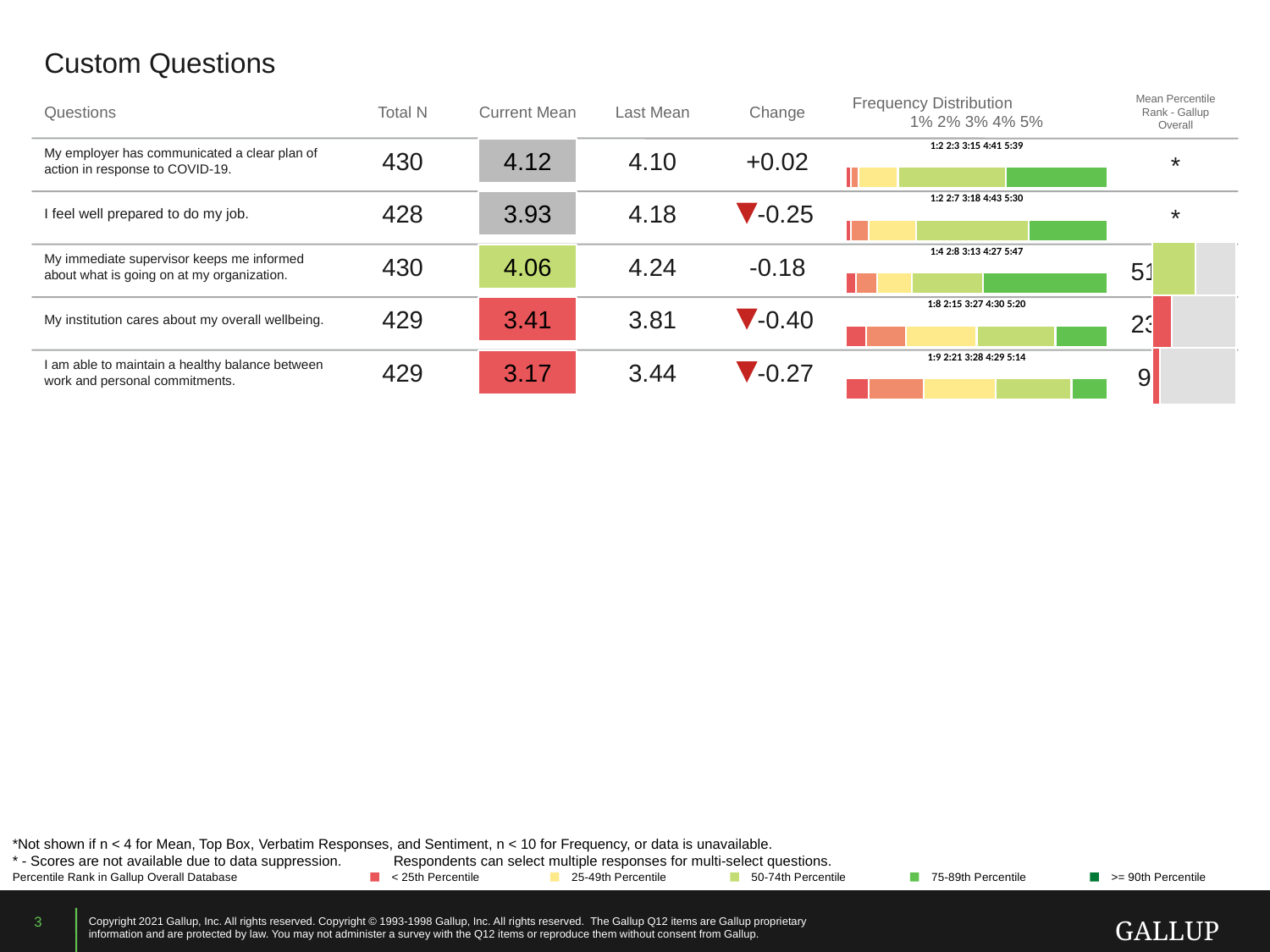
In the Frequency Distribution bar for "My employer has communicated a clear plan of action in response to COVID-19", what percentage chose 5? 39 In the Frequency Distribution bar for "I feel well prepared to do my job", what percentage of respondents chose 4? 43 Is the Mean Percentile Rank for "My institution cares about my overall wellbeing" greater or less than 50? less In the Frequency Distribution bar for "My institution cares about my overall wellbeing", which response option has the largest share? 4 In the Frequency Distribution bar for "I feel well prepared to do my job", which has the larger share: response 3 or response 5? 5 In the Frequency Distribution bar for "I am able to maintain a healthy balance between work and personal commitments", which response option has the smallest share? 1 In the Frequency Distribution bar for "My employer has communicated a clear plan of action in response to COVID-19", what is the difference between the shares for 4 and 5? 2 Which question has the lowest Mean Percentile Rank - Gallup Overall shown? I am able to maintain a healthy balance between work and personal commitments. How many response segments does each Frequency Distribution bar contain? 5 How many percentile categories does the legend at the bottom of the slide list? 5 What is the Mean Percentile Rank - Gallup Overall for "My immediate supervisor keeps me informed about what is going on at my organization"? 51 What kind of chart is used in the Frequency Distribution column? Stacked bar chart